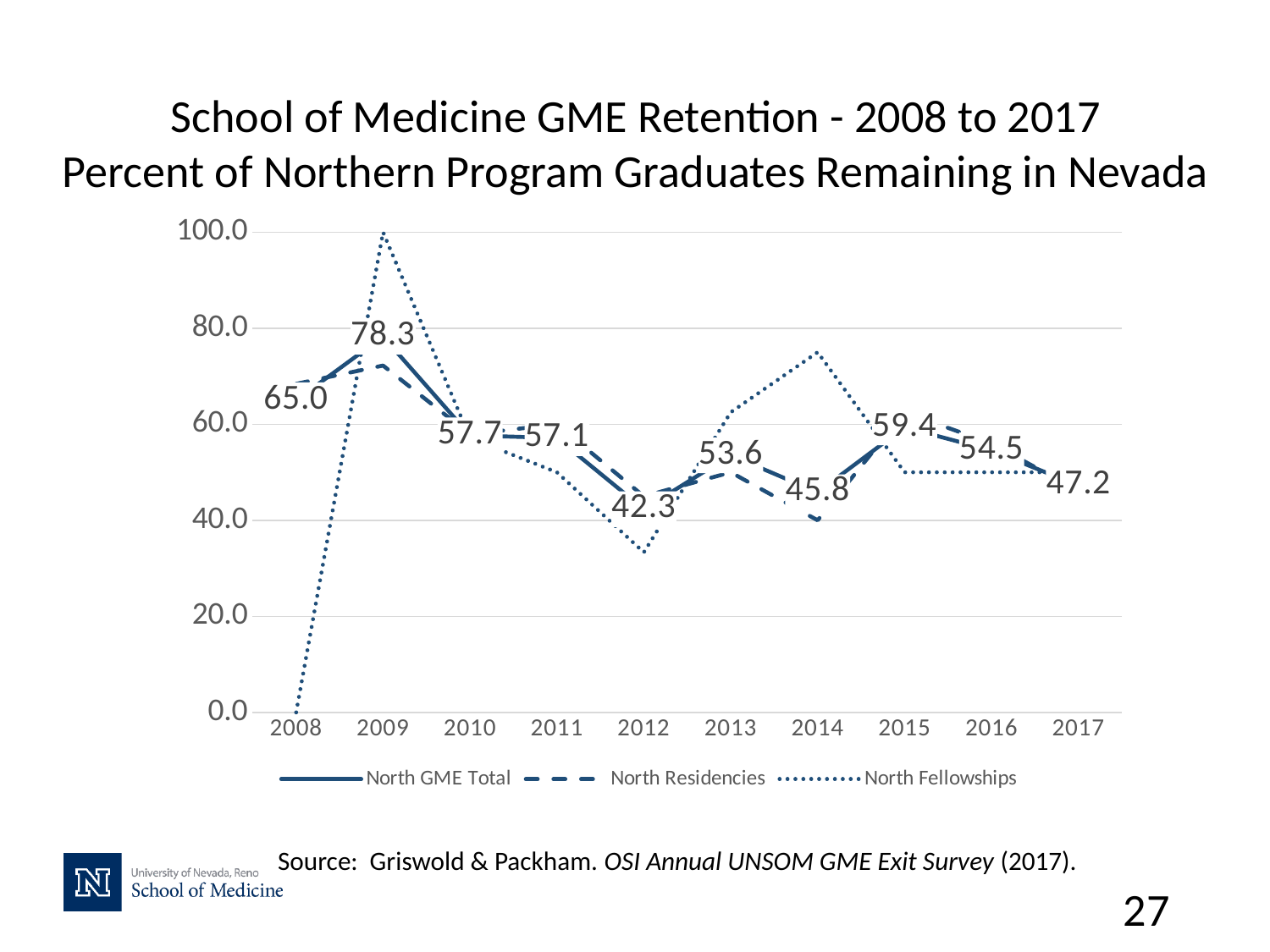
Does the North GME Total value rise or fall from 2015 to 2017? fall What is the North GME Total value for 2017? 47.2 Which year has the larger North GME Total value, 2015 or 2016? 2015 How many series does the legend list? 3 What kind of chart is shown on the slide? line chart In which year is the North GME Total value highest? 2009 In which year is the North GME Total value lowest? 2012 Is the North Fellowships value for 2014 greater or less than 60.0? greater How many years are shown on the x axis? 10 What is the North GME Total value for 2009? 78.3 What is the difference between the North GME Total values for 2009 and 2012? 36.0 Which series is drawn with a dotted line? North Fellowships